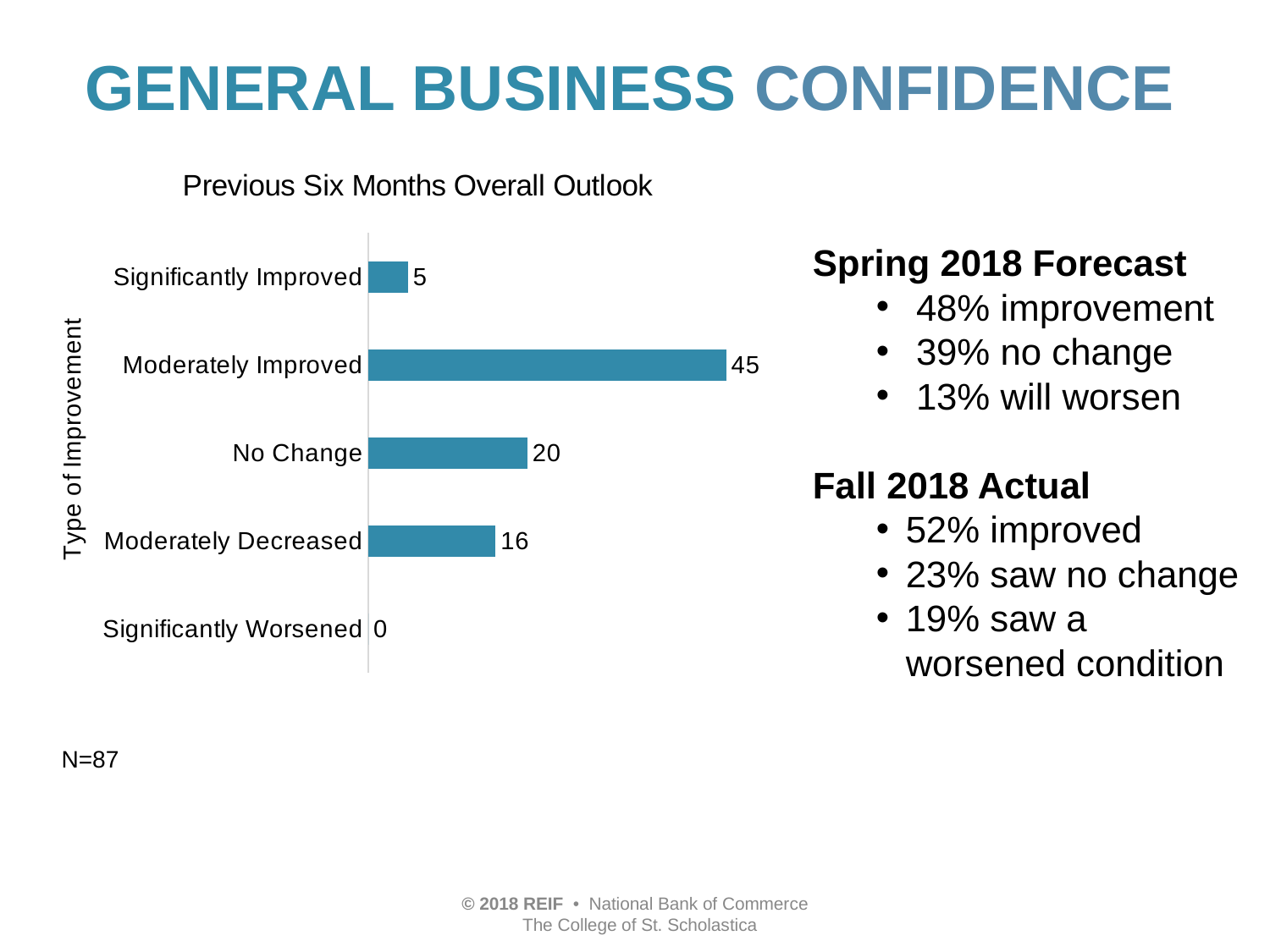
What is the difference between the values for Moderately Improved and No Change? 25 Which category has the lowest value? Significantly Worsened Which is larger, the value for Significantly Improved or the value for Moderately Decreased? Moderately Decreased What is the value for Moderately Decreased? 16 What is the title of the chart? Previous Six Months Overall Outlook Which category has the highest value? Moderately Improved What is the difference between the values for No Change and Moderately Decreased? 4 What kind of chart is shown on the slide? Bar chart What is the value for No Change? 20 What is the value for Moderately Improved? 45 How many categories are shown in the chart? 5 What is the value for Significantly Worsened? 0